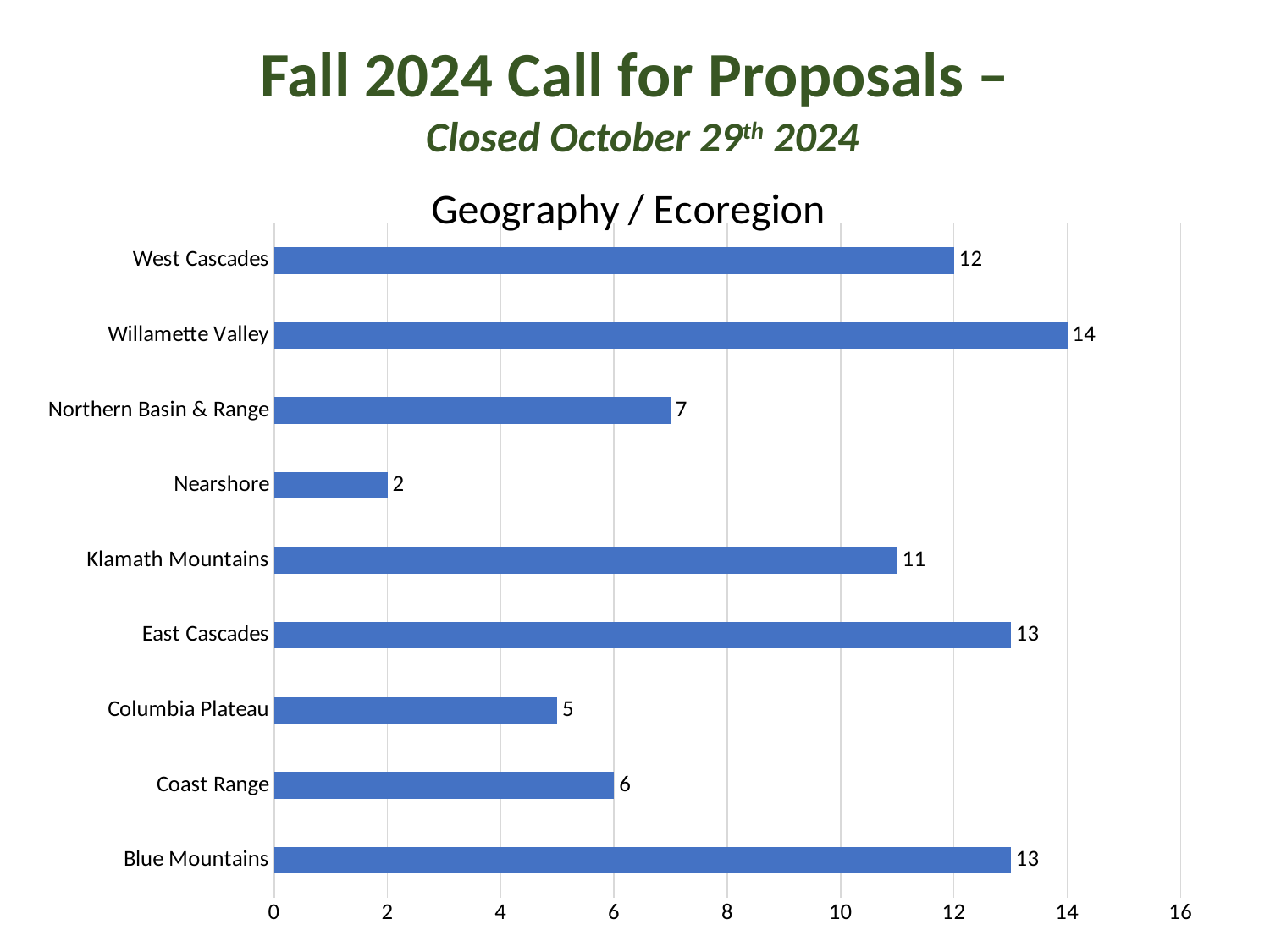
What is the value for Willamette Valley? 14 Which is larger, the value for Northern Basin & Range or the value for Columbia Plateau? Northern Basin & Range What is the value for Nearshore? 2 What is the title of the chart? Geography / Ecoregion What is the value for Klamath Mountains? 11 Which category has the lowest value? Nearshore What is the difference between the values for West Cascades and Coast Range? 6 How many categories are shown on the chart? 9 What is the highest value shown on the x axis? 16 What kind of chart is shown on the slide? Bar chart Is the value for East Cascades greater or less than 10? greater Which category has the highest value? Willamette Valley